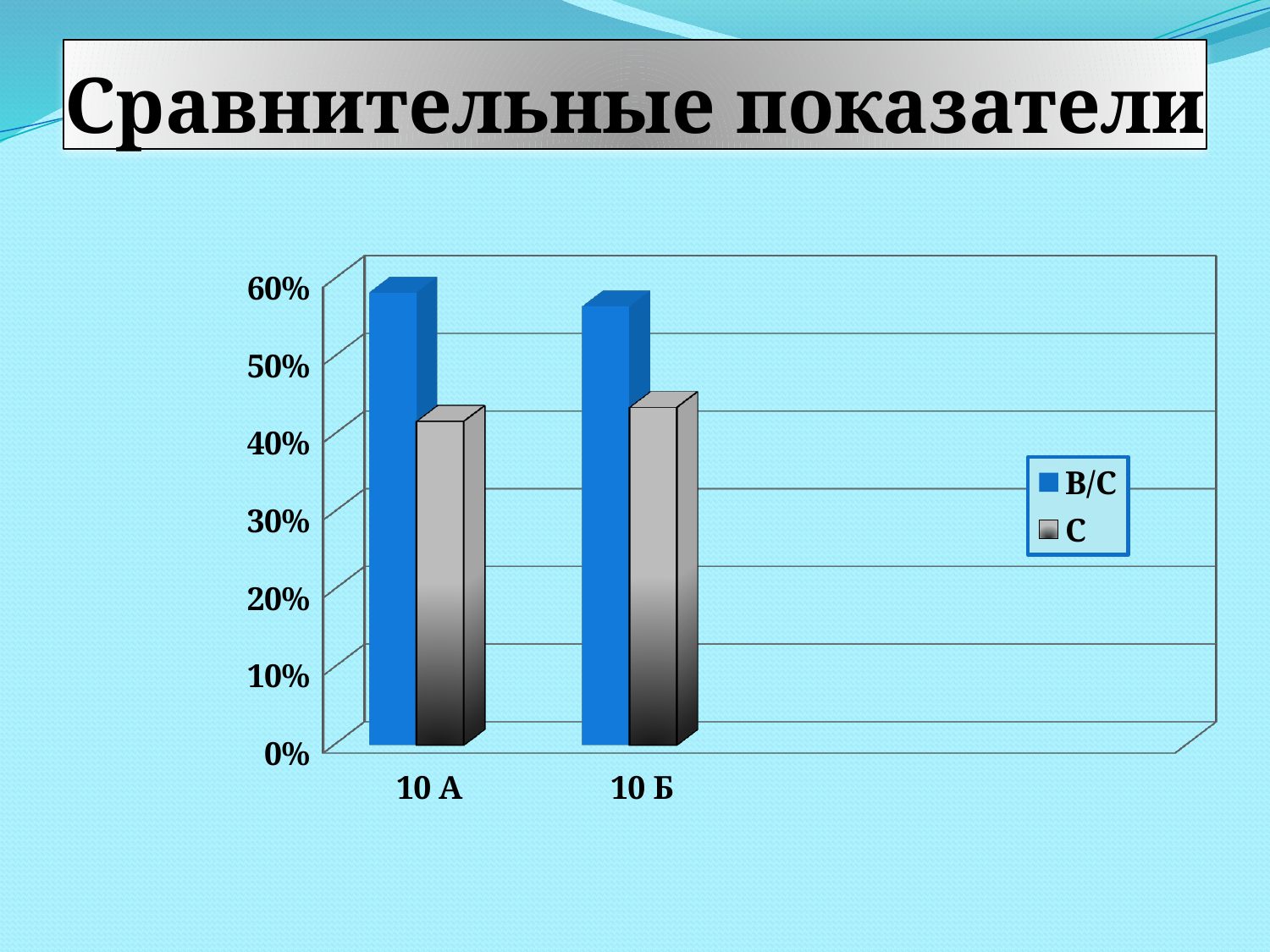
Is the value of С for 10 Б greater or less than 30%? greater Is the value of С for 10 А greater or less than 50%? less Is the value of В/С for 10 А greater or less than 50%? greater What are the two series listed in the chart's legend? В/С and С What colour are the bars for the series В/С? blue What kind of chart is shown on the slide? bar chart How many categories are shown on the x axis of the chart? 2 For 10 Б, which series has the larger value, В/С or С? В/С How many series does the chart's legend list? 2 For 10 А, which series has the larger value, В/С or С? В/С